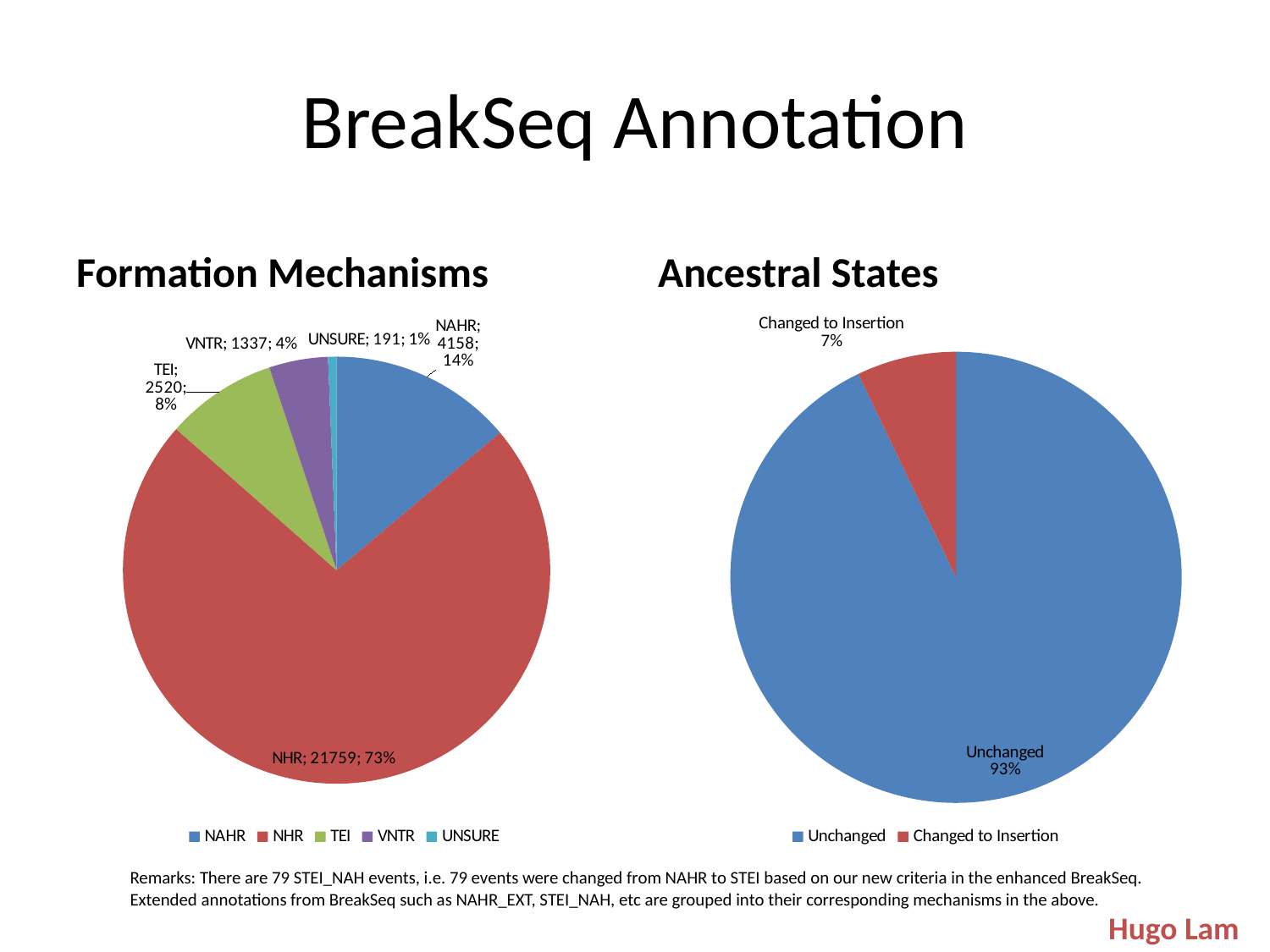
In the Formation Mechanisms chart, which is larger, VNTR or UNSURE? VNTR In the Formation Mechanisms chart, which category has the largest slice? NHR In the Ancestral States chart, what share is Changed to Insertion? 7% In the Formation Mechanisms chart, what percentage share does VNTR have? 4% How many categories does the Formation Mechanisms chart show? 5 In the Ancestral States chart, which category has the larger share? Unchanged What type of chart is the Ancestral States chart? Pie chart In the Formation Mechanisms chart, which category has the smallest slice? UNSURE In the Formation Mechanisms chart, what is the value for NHR? 21759 In the Formation Mechanisms chart, what is the value for TEI? 2520 In the Formation Mechanisms chart, what is the value for NAHR? 4158 In the Formation Mechanisms chart, what is the difference between the NAHR and TEI values? 1638